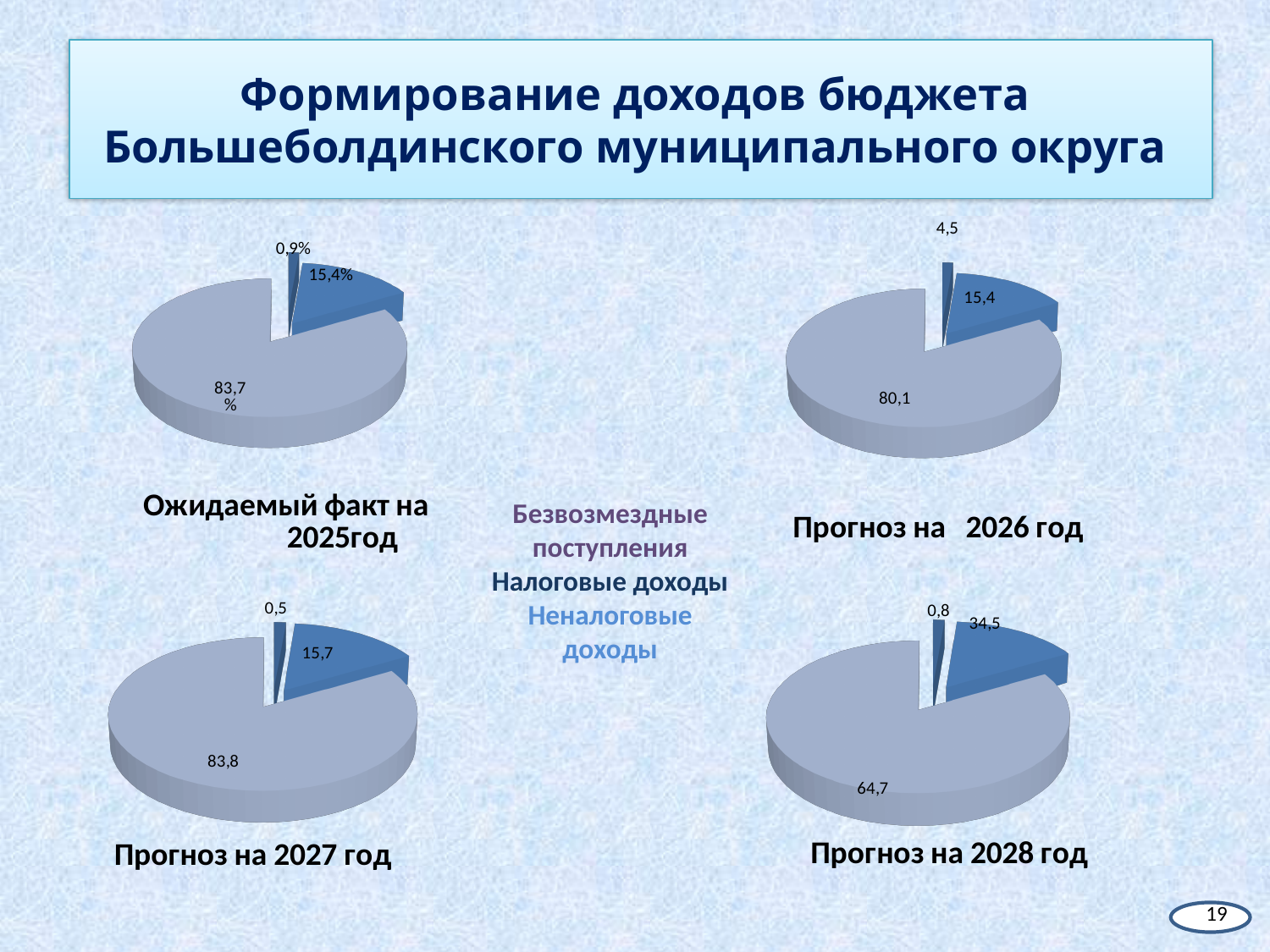
In the "Прогноз на 2026 год" chart, what is the value of the largest slice? 80,1 In the "Прогноз на 2027 год" chart, what is the value of the smallest slice? 0,5 In the "Прогноз на 2028 год" chart, what is the value of the medium blue slice? 34,5 Which chart has the larger largest slice: "Прогноз на 2027 год" or "Прогноз на 2028 год"? Прогноз на 2027 год In the "Прогноз на 2028 год" chart, what is the difference between the largest slice (64,7) and the medium blue slice (34,5)? 30,2 In the "Ожидаемый факт на 2025год" chart, what is the value of the largest slice? 83,7% How many entries does the legend in the middle of the slide list? 3 What kind of chart is "Ожидаемый факт на 2025год"? pie chart In the "Прогноз на 2026 год" chart, what is the value of the smallest slice? 4,5 In the "Ожидаемый факт на 2025год" chart, what is the value of the smallest slice? 0,9% In the "Прогноз на 2028 год" chart, what is the value of the largest slice? 64,7 How many slices does the "Прогноз на 2027 год" pie chart have? 3